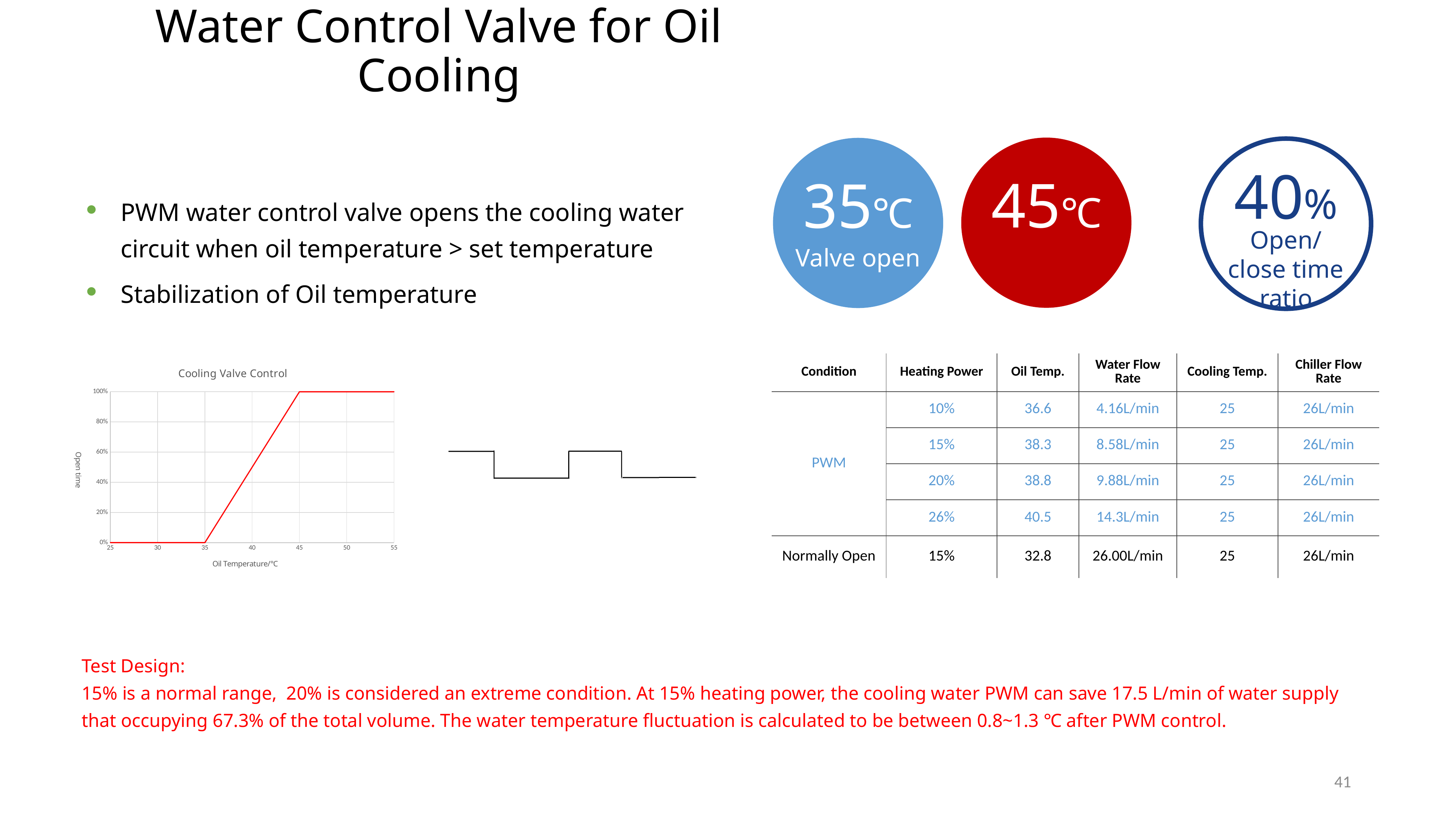
What is the title of the chart on the left of the slide? Cooling Valve Control In the Cooling Valve Control chart, what is the open time at an oil temperature of 35? 0% What is the x-axis label of the Cooling Valve Control chart? Oil Temperature/°C In the Cooling Valve Control chart, does the open time rise or fall as oil temperature increases from 35 to 45? rise In the Cooling Valve Control chart, is the open time at an oil temperature of 40 greater or less than 20%? greater In the Cooling Valve Control chart, which oil temperature has the higher open time, 35 or 45? 45 What kind of chart is the Cooling Valve Control chart? line chart In the Cooling Valve Control chart, is the open time at an oil temperature of 40 greater or less than 80%? less In the Cooling Valve Control chart, what is the open time at an oil temperature of 45? 100% In the Cooling Valve Control chart, what is the open time at an oil temperature of 55? 100% In the Cooling Valve Control chart, what is the open time at an oil temperature of 25? 0% In the Cooling Valve Control chart, what is the difference between the open time at 45 and the open time at 35? 100%